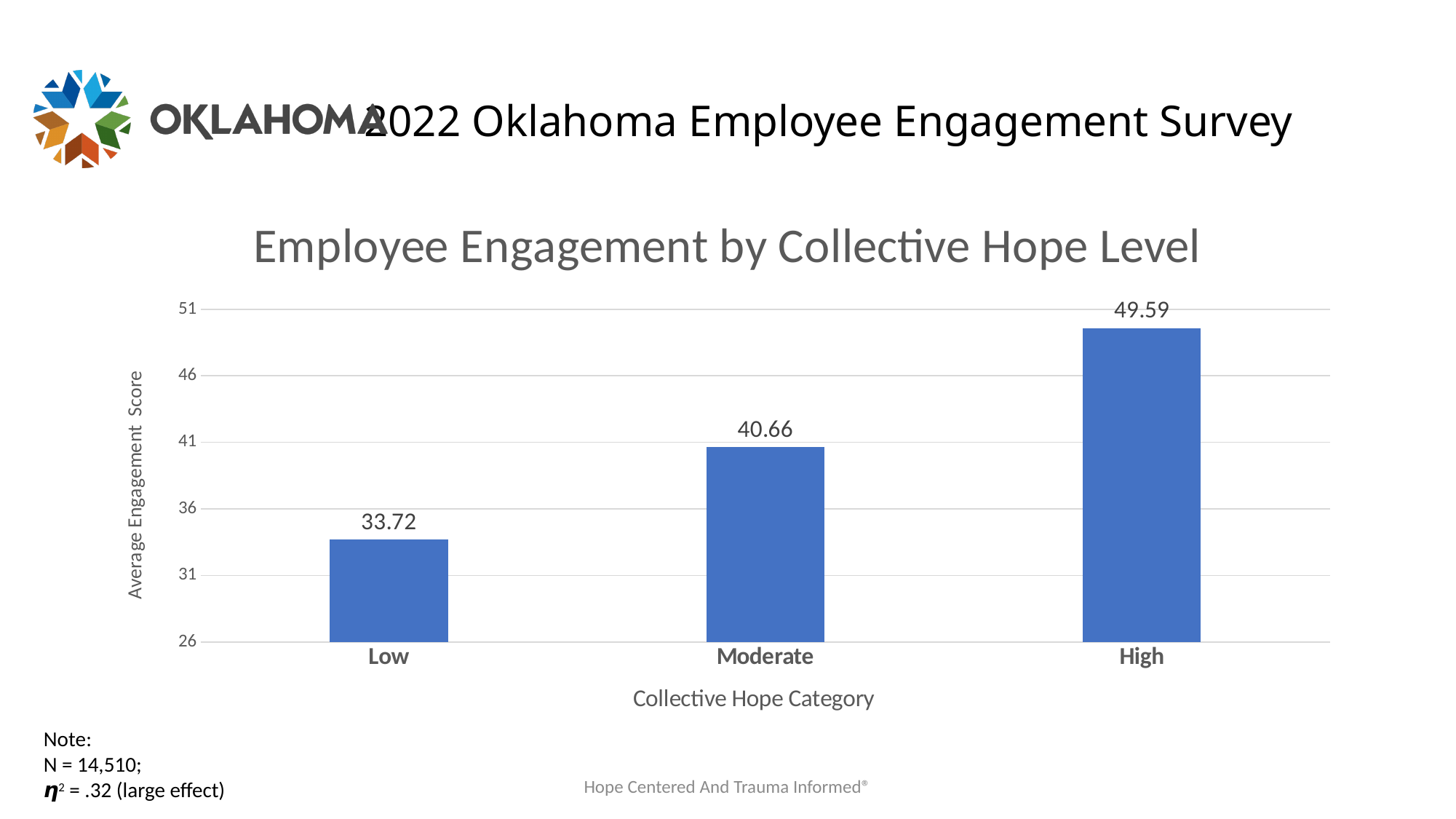
What kind of chart is shown on the slide? Bar chart How many collective hope categories are shown on the chart? 3 Do the average engagement scores rise or fall from Low to High collective hope? Rise Which collective hope category has the lowest average engagement score? Low What is the difference in average engagement score between the Moderate and Low categories? 6.94 What is the difference in average engagement score between the High and Low categories? 15.87 What is the average engagement score for the Low collective hope category? 33.72 Which collective hope category has the highest average engagement score? High Is the value for Moderate greater or less than 41? less Which has a higher average engagement score, Moderate or High? High What is the average engagement score for the Moderate collective hope category? 40.66 What is the average engagement score for the High collective hope category? 49.59